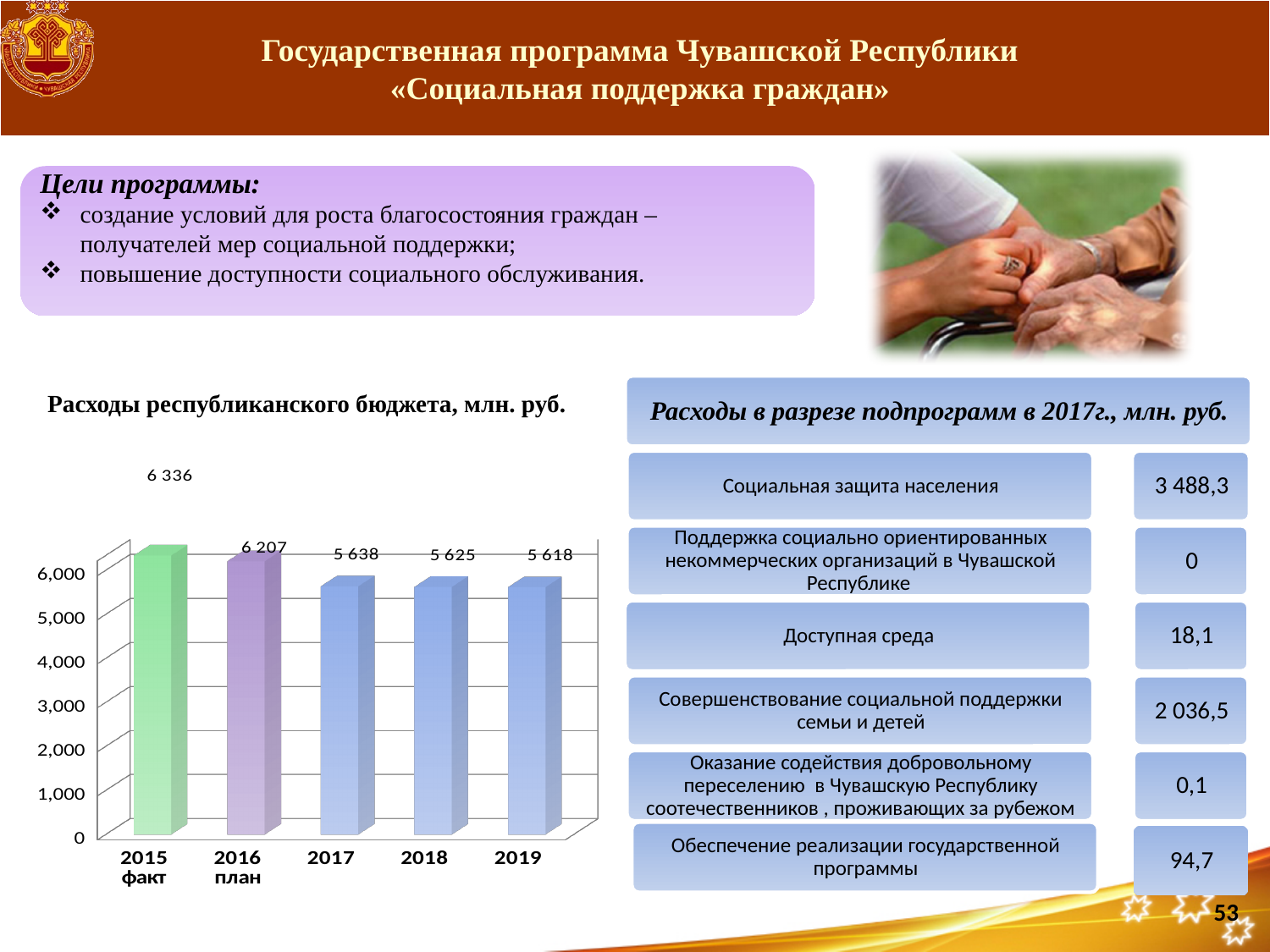
How many bars are shown in the chart 'Расходы республиканского бюджета, млн. руб.'? 5 What is the value for 2015 факт in the chart 'Расходы республиканского бюджета, млн. руб.'? 6 336 Which year has the highest value in the chart 'Расходы республиканского бюджета, млн. руб.'? 2015 факт In the chart 'Расходы республиканского бюджета, млн. руб.', is the value for 2018 greater or less than 5,000? greater In the chart 'Расходы республиканского бюджета, млн. руб.', which is larger: the value for 2017 or the value for 2018? 2017 What is the difference between the values for 2017 and 2019 in the chart 'Расходы республиканского бюджета, млн. руб.'? 20 Do the values in the chart 'Расходы республиканского бюджета, млн. руб.' rise or fall from 2015 to 2019? fall What is the value for 2019 in the chart 'Расходы республиканского бюджета, млн. руб.'? 5 618 Which year has the lowest value in the chart 'Расходы республиканского бюджета, млн. руб.'? 2019 What is the value for 2016 план in the chart 'Расходы республиканского бюджета, млн. руб.'? 6 207 What kind of chart is 'Расходы республиканского бюджета, млн. руб.'? bar chart What is the difference between the values for 2015 факт and 2016 план in the chart 'Расходы республиканского бюджета, млн. руб.'? 129